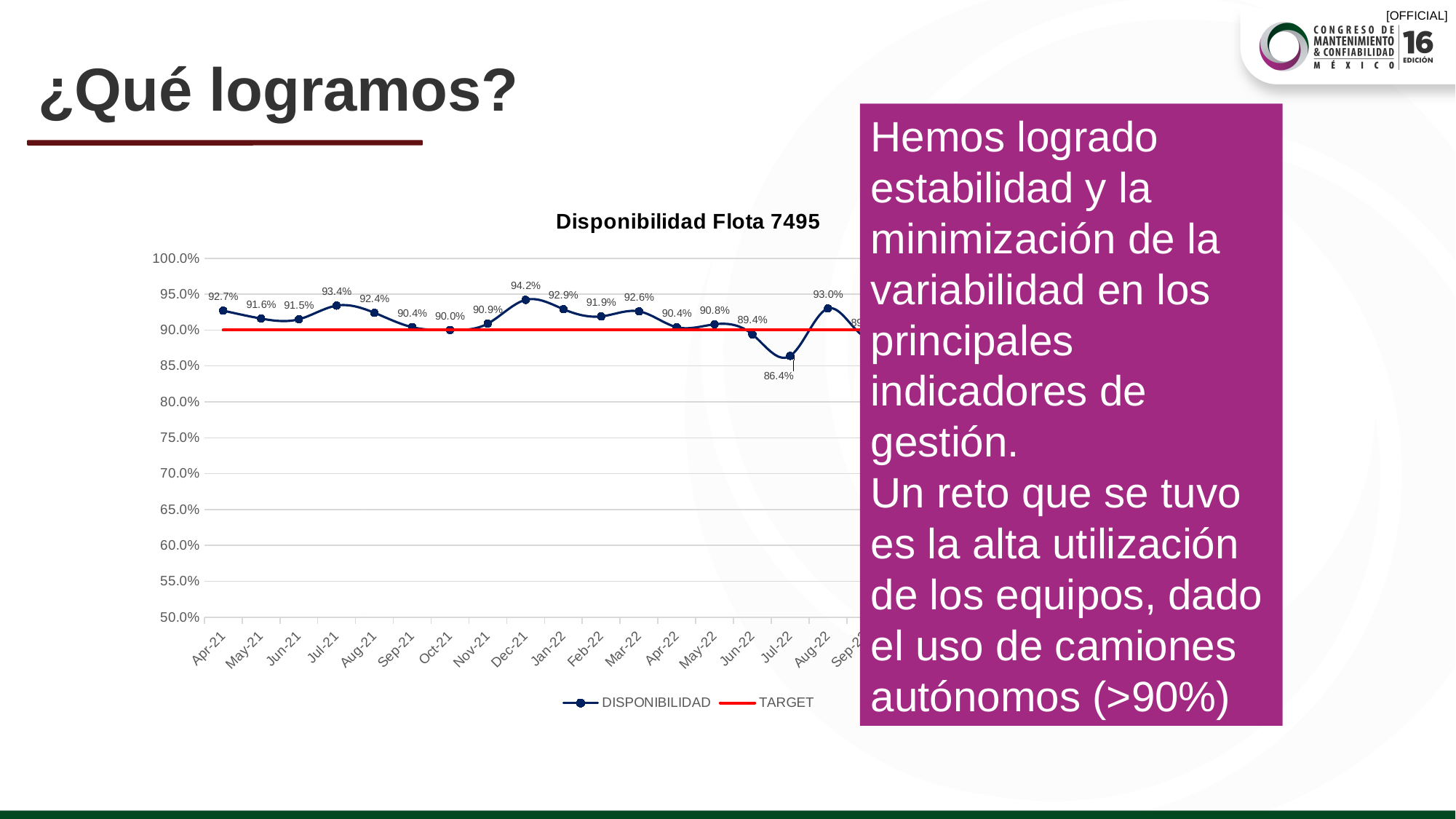
Does the DISPONIBILIDAD value rise or fall from Jul-22 to Aug-22? rise What is the DISPONIBILIDAD value for Dec-21? 94.2% How many series does the chart legend list? 2 Is the DISPONIBILIDAD value for Jun-22 greater or less than 90.0%? less Which month has the lowest DISPONIBILIDAD value? Jul-22 What is the DISPONIBILIDAD value for Jul-22? 86.4% What kind of chart is shown on the slide? line chart What is the DISPONIBILIDAD value for Apr-21? 92.7% Which month has the highest DISPONIBILIDAD value? Dec-21 What is the title of the chart? Disponibilidad Flota 7495 Which is larger, the DISPONIBILIDAD value for Jul-21 or for Aug-21? Jul-21 What is the difference between the DISPONIBILIDAD values for Dec-21 and Jul-22? 7.8%